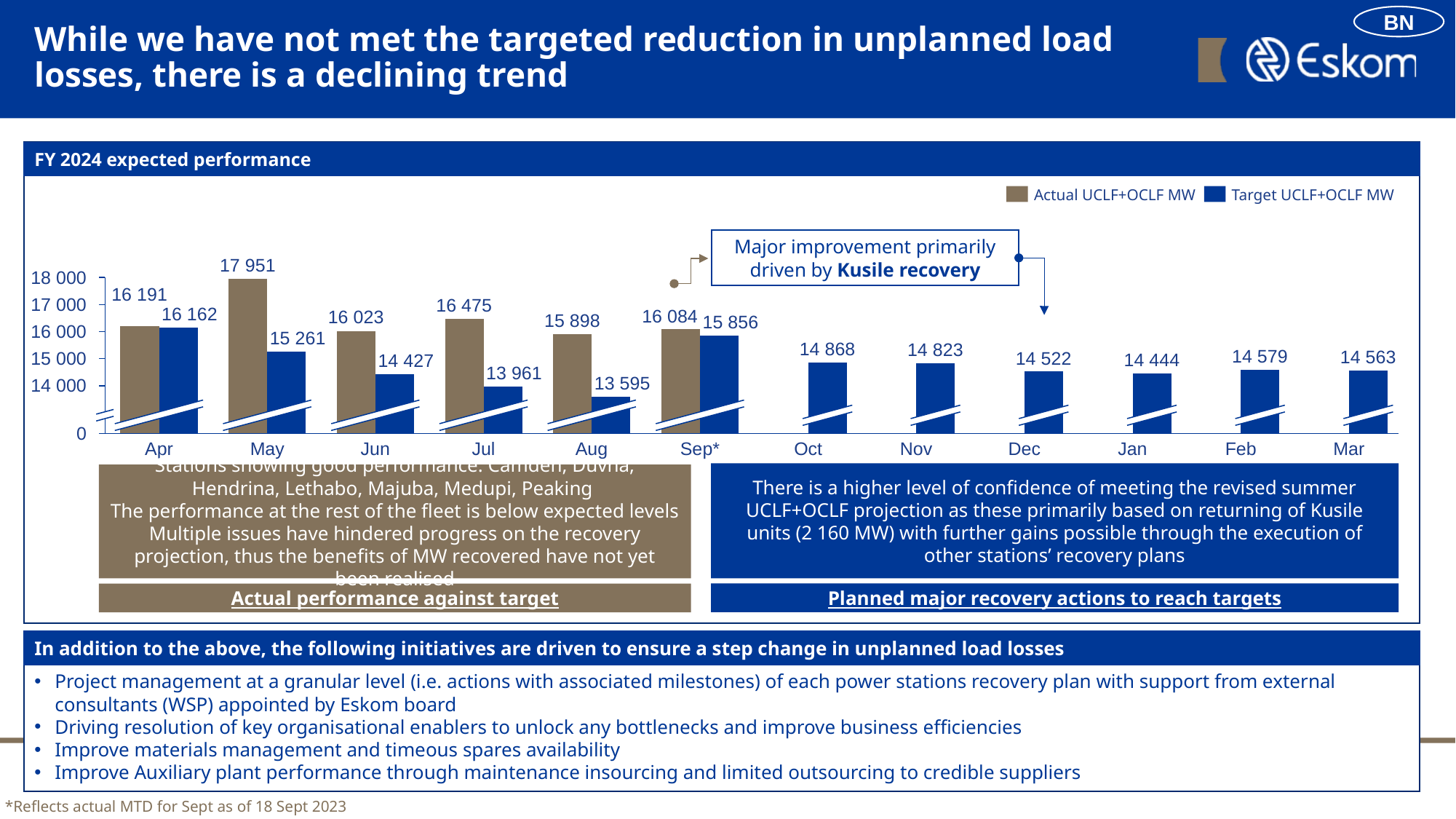
What is the difference between the Actual and Target UCLF+OCLF MW values for Apr? 29 How many series does the chart legend list? 2 What is the Target UCLF+OCLF MW value for Jan? 14 444 Which month has the highest Actual UCLF+OCLF MW value? May What kind of chart is shown under 'FY 2024 expected performance'? Bar chart How many months are shown on the x axis of the chart? 12 What is the difference between the Actual and Target UCLF+OCLF MW values for May? 2 690 What is the Actual UCLF+OCLF MW value for May? 17 951 Which is larger, the Actual UCLF+OCLF MW value for Jul or the Target UCLF+OCLF MW value for Jul? Actual UCLF+OCLF MW Does the Target UCLF+OCLF MW value rise or fall from May to Aug? Fall What is the Target UCLF+OCLF MW value for Aug? 13 595 Which month has the lowest Target UCLF+OCLF MW value? Aug